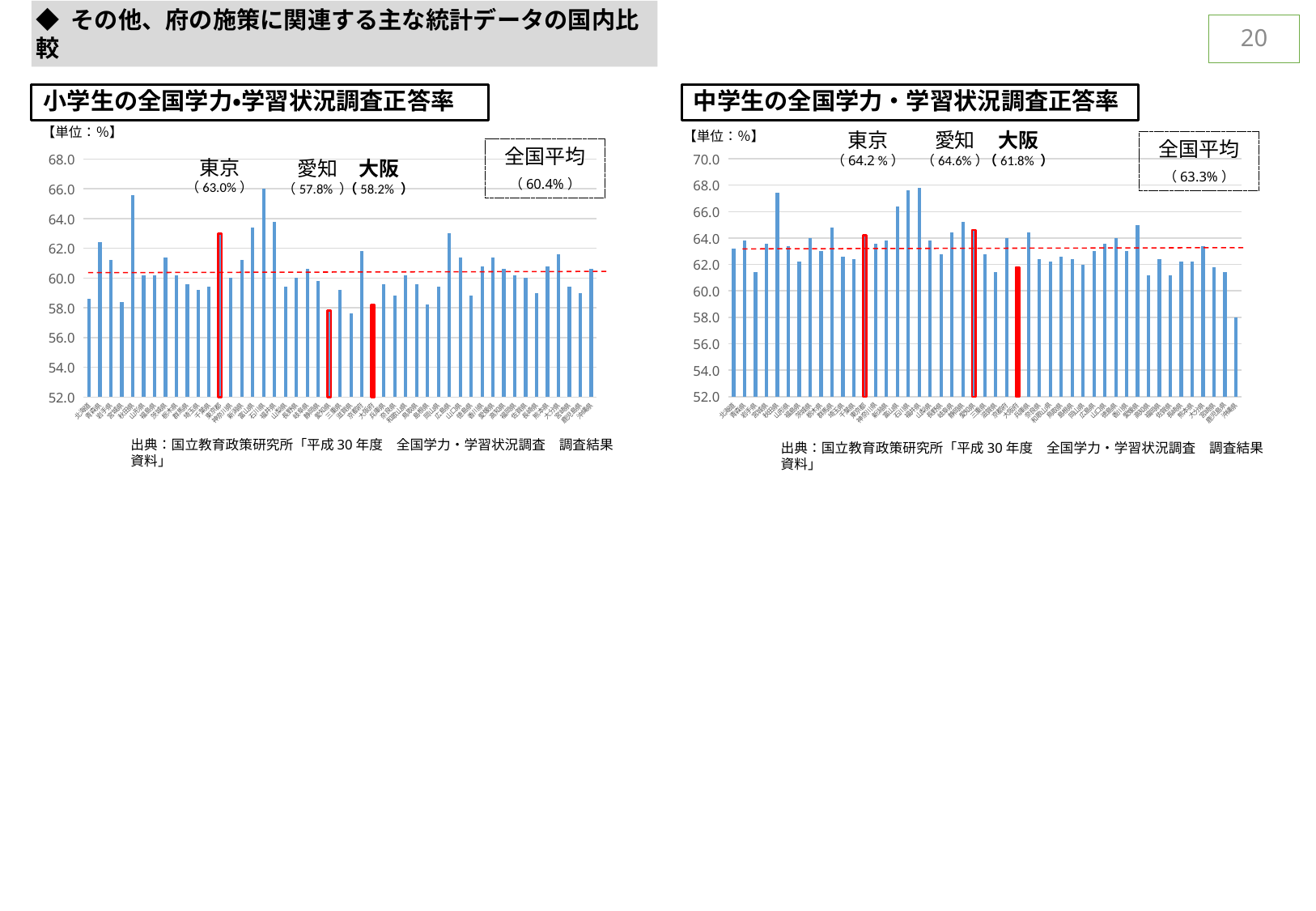
In the 小学生の全国学力•学習状況調査正答率 chart (left), is the value for 大阪 greater or less than 60.0? less In the 小学生の全国学力•学習状況調査正答率 chart (left), what is the difference between the values for 東京 and 大阪? 4.8 In the 小学生の全国学力•学習状況調査正答率 chart (left), what is the value for 大阪? 58.2% In the 中学生の全国学力・学習状況調査正答率 chart (right), what is the value for 大阪? 61.8% In the 小学生の全国学力•学習状況調査正答率 chart (left), what is the value for 愛知? 57.8% In the 中学生の全国学力・学習状況調査正答率 chart (right), which has the higher value, 東京 or 愛知? 愛知 What kind of chart is the 中学生の全国学力・学習状況調査正答率 chart (right)? bar chart In the 中学生の全国学力・学習状況調査正答率 chart (right), what is the value for 愛知? 64.6% In the 中学生の全国学力・学習状況調査正答率 chart (right), what is the 全国平均 (national average)? 63.3% In the 中学生の全国学力・学習状況調査正答率 chart (right), what is the value for 東京? 64.2% In the 小学生の全国学力•学習状況調査正答率 chart (left), what is the 全国平均 (national average)? 60.4% In the 小学生の全国学力•学習状況調査正答率 chart (left), what is the value for 東京? 63.0%